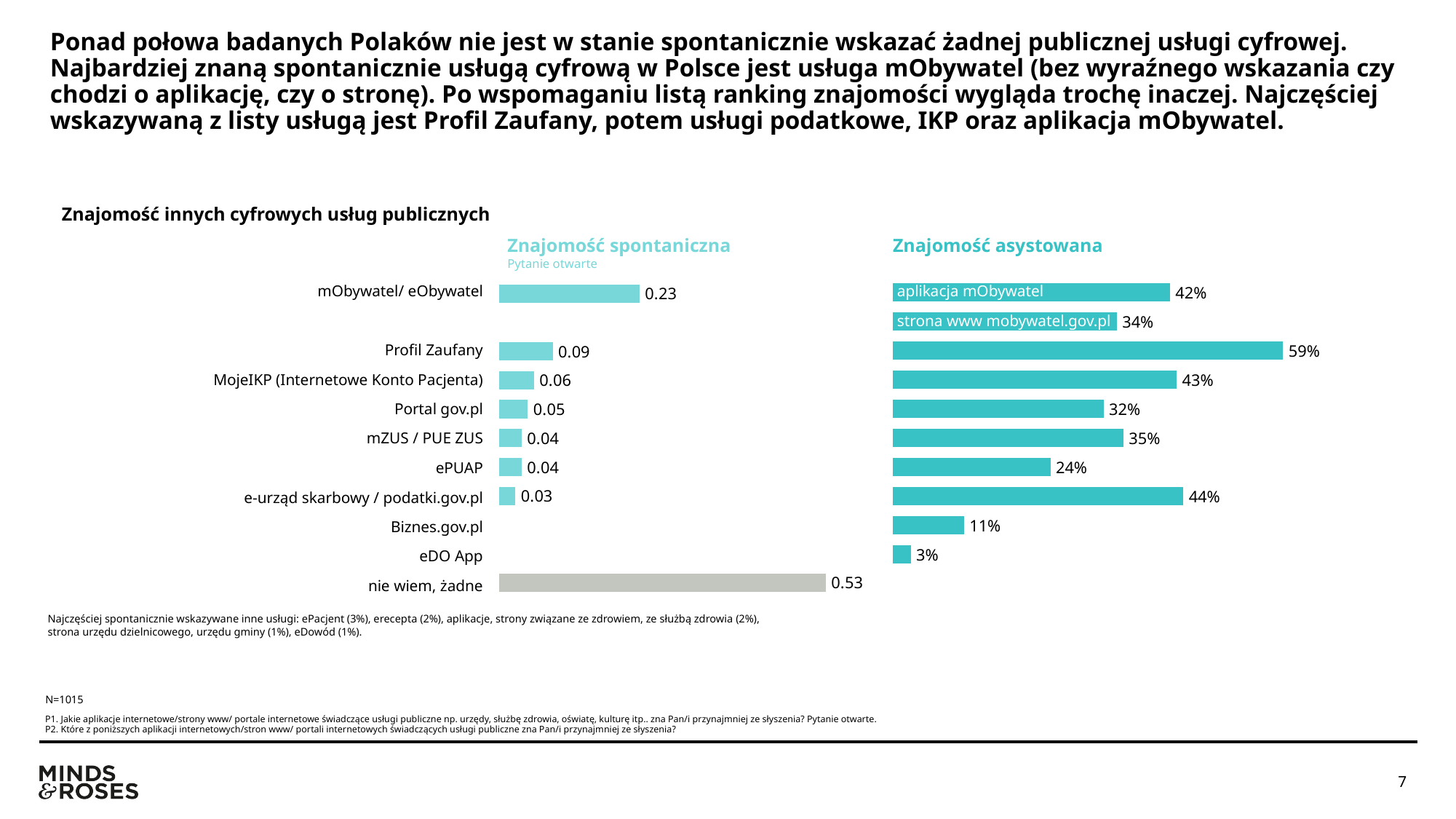
In the 'Znajomość asystowana' chart, what is the difference between the values for aplikacja mObywatel and strona www mobywatel.gov.pl? 8 percentage points In the 'Znajomość asystowana' chart, what is the value for Profil Zaufany? 59% In the 'Znajomość asystowana' chart, what is the value for eDO App? 3% In the 'Znajomość spontaniczna' chart, which named service (excluding 'nie wiem, żadne') has the highest value? mObywatel/ eObywatel In the 'Znajomość spontaniczna' chart, what is the value for mObywatel/ eObywatel? 0.23 In the 'Znajomość spontaniczna' chart, what is the difference between the values for Profil Zaufany and MojeIKP (Internetowe Konto Pacjenta)? 0.03 In the 'Znajomość asystowana' chart, which is larger: the value for e-urząd skarbowy / podatki.gov.pl or the value for MojeIKP (Internetowe Konto Pacjenta)? e-urząd skarbowy / podatki.gov.pl What type of chart is used for 'Znajomość spontaniczna'? Bar chart In the 'Znajomość asystowana' chart, what is the value for ePUAP? 24% In the 'Znajomość asystowana' chart, which category has the highest value? Profil Zaufany In the 'Znajomość spontaniczna' chart, what is the value for 'nie wiem, żadne'? 0.53 In the 'Znajomość asystowana' chart, which category has the lowest value? eDO App